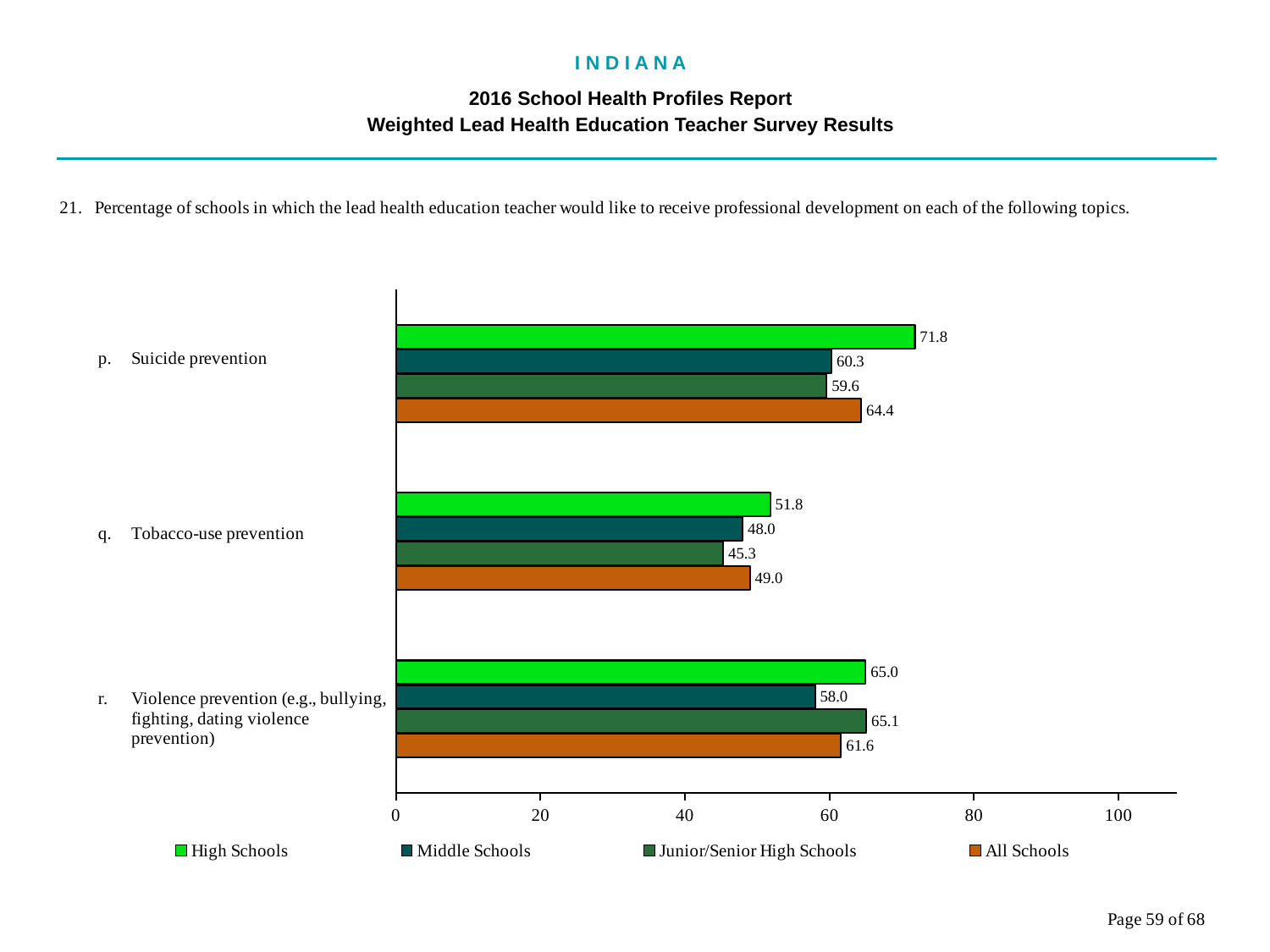
What kind of chart is shown on the slide? bar chart Which topic has the lowest value for All Schools? Tobacco-use prevention What is the difference between the High Schools and Middle Schools values for Suicide prevention? 11.5 Which is larger for Violence prevention: the High Schools value or the All Schools value? High Schools What is the value for All Schools for Tobacco-use prevention? 49.0 What is the value for High Schools for Suicide prevention? 71.8 Is the value for Middle Schools for Tobacco-use prevention greater or less than 60? less How many series does the legend list? 4 What is the value for Junior/Senior High Schools for Tobacco-use prevention? 45.3 Which topic has the highest value for High Schools? Suicide prevention What is the value for Middle Schools for Violence prevention? 58.0 How many topics are shown on the chart? 3